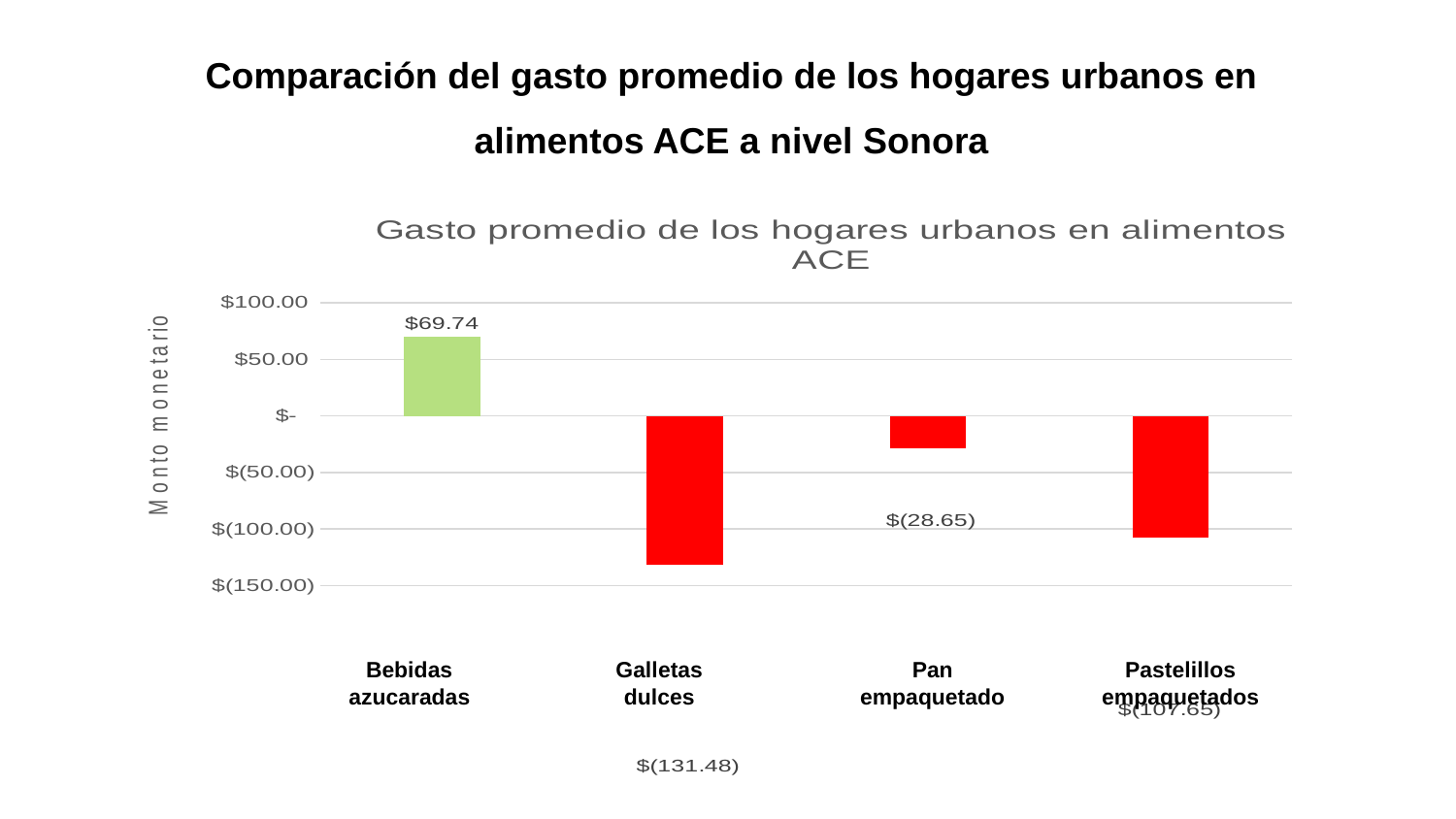
Is the value for Pastelillos empaquetados greater or less than $(100.00)? less How many categories are plotted in the chart? 4 Which category has the highest value? Bebidas azucaradas What is the value for Bebidas azucaradas? $69.74 What kind of chart is shown on the slide? bar chart How many categories have negative values? 3 Which has the larger value, Galletas dulces or Pan empaquetado? Pan empaquetado Which category has the lowest value? Galletas dulces What is the value for Galletas dulces? $(131.48) What is the label on the vertical axis of the chart? Monto monetario What is the value for Pan empaquetado? $(28.65) What is the difference between the values for Bebidas azucaradas and Pan empaquetado? $98.39